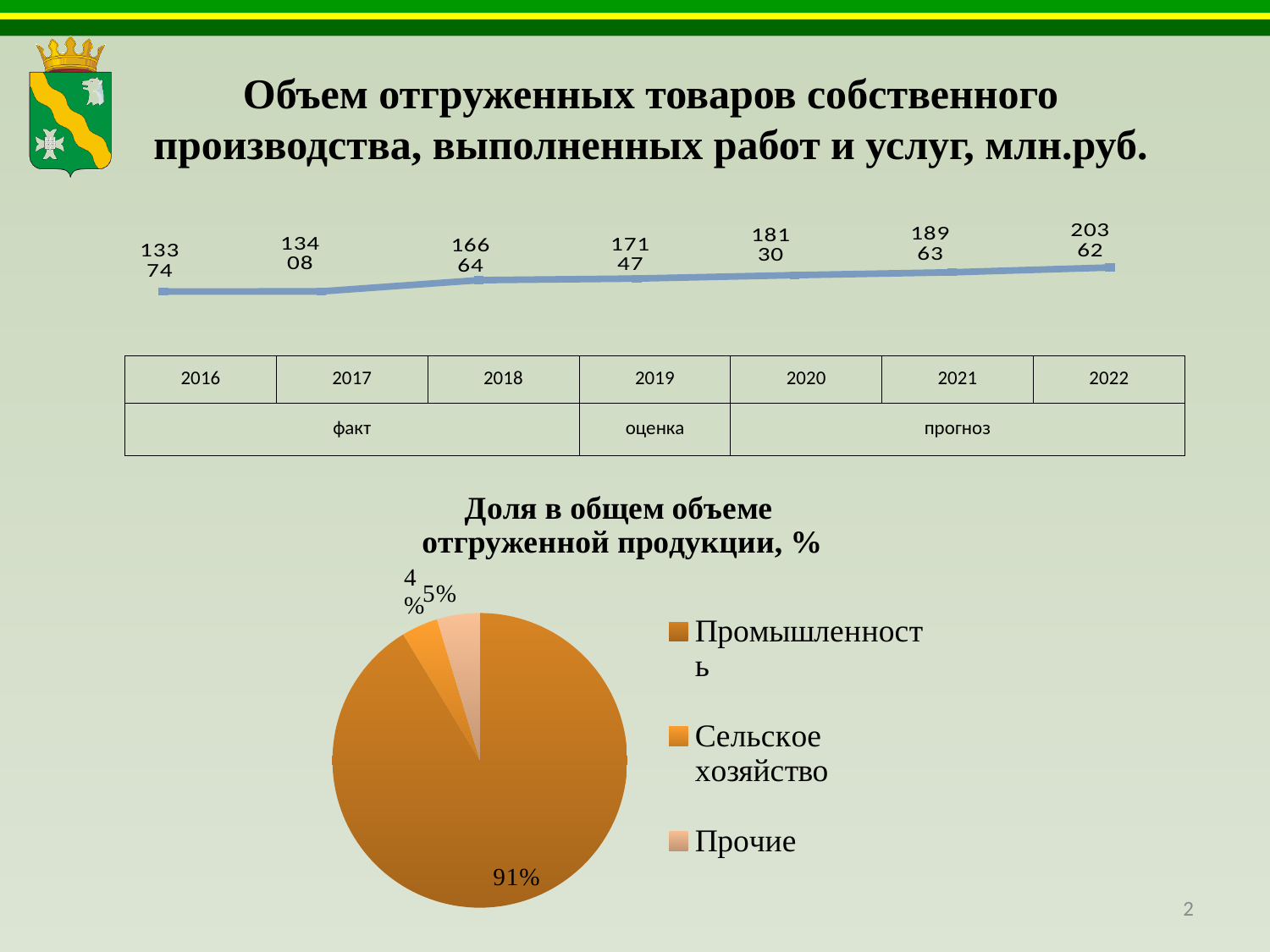
In the pie chart "Доля в общем объеме отгруженной продукции, %", what share does Промышленность have? 91% In the pie chart "Доля в общем объеме отгруженной продукции, %", which category has the largest slice? Промышленность How many entries does the legend of the pie chart "Доля в общем объеме отгруженной продукции, %" list? 3 In the top line chart, do the values rise or fall from 2016 to 2022? rise In the top line chart, which year has the highest value? 2022 In the top line chart, which year has the larger value, 2017 or 2021? 2021 How many slices does the pie chart "Доля в общем объеме отгруженной продукции, %" have? 3 In the top line chart, which year has the lowest value? 2016 In the top chart, which years are labelled as "прогноз" (forecast)? 2020, 2021, 2022 What kind of chart is the top chart titled "Объем отгруженных товаров собственного производства, выполненных работ и услуг, млн.руб."? line chart In the top line chart, how many data points are plotted? 7 What kind of chart is the bottom chart titled "Доля в общем объеме отгруженной продукции, %"? pie chart